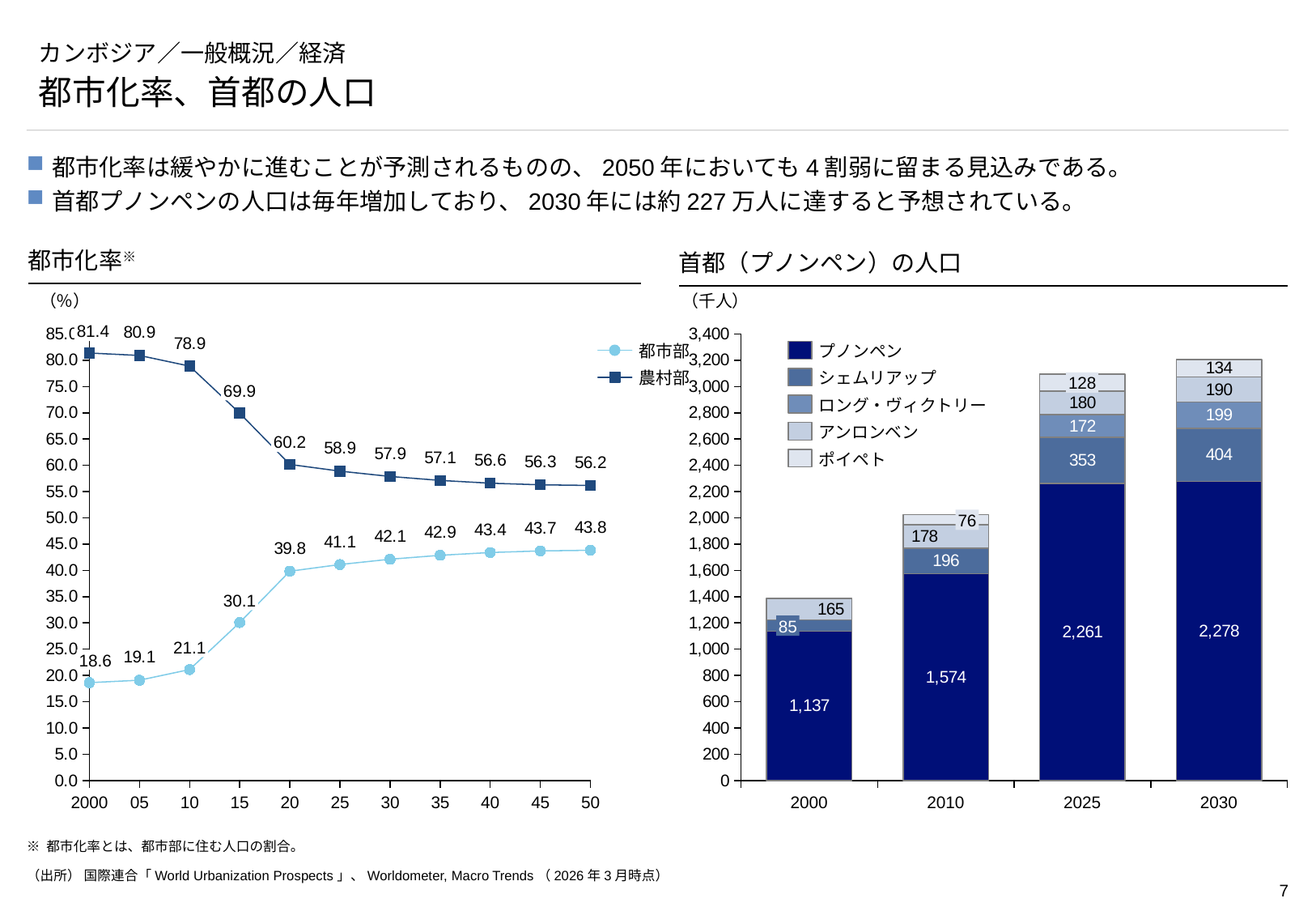
In the 首都（プノンペン）の人口 chart, what is the value for プノンペン in 2030? 2,278 In the 都市化率 chart, what is the value for 農村部 in 2000? 81.4 In the 都市化率 chart, in which year is the 都市部 value highest? 2050 In the 首都（プノンペン）の人口 chart, is the シェムリアップ value larger in 2025 or in 2030? 2030 In the 都市化率 chart, what is the difference between the 農村部 values for 2000 and 2050? 25.2 How many series does the legend of the 都市化率 chart list? 2 What kind of chart is the 首都（プノンペン）の人口 chart on the right? stacked bar chart In the 都市化率 chart, does the 都市部 series rise or fall from 2000 to 2050? rise In the 都市化率 chart, what is the value for 都市部 in 2020? 39.8 In the 首都（プノンペン）の人口 chart, what is the total of the stacked bar for 2025? 3,094 What kind of chart is the 都市化率 chart on the left? line chart How many series does the legend of the 首都（プノンペン）の人口 chart list? 5